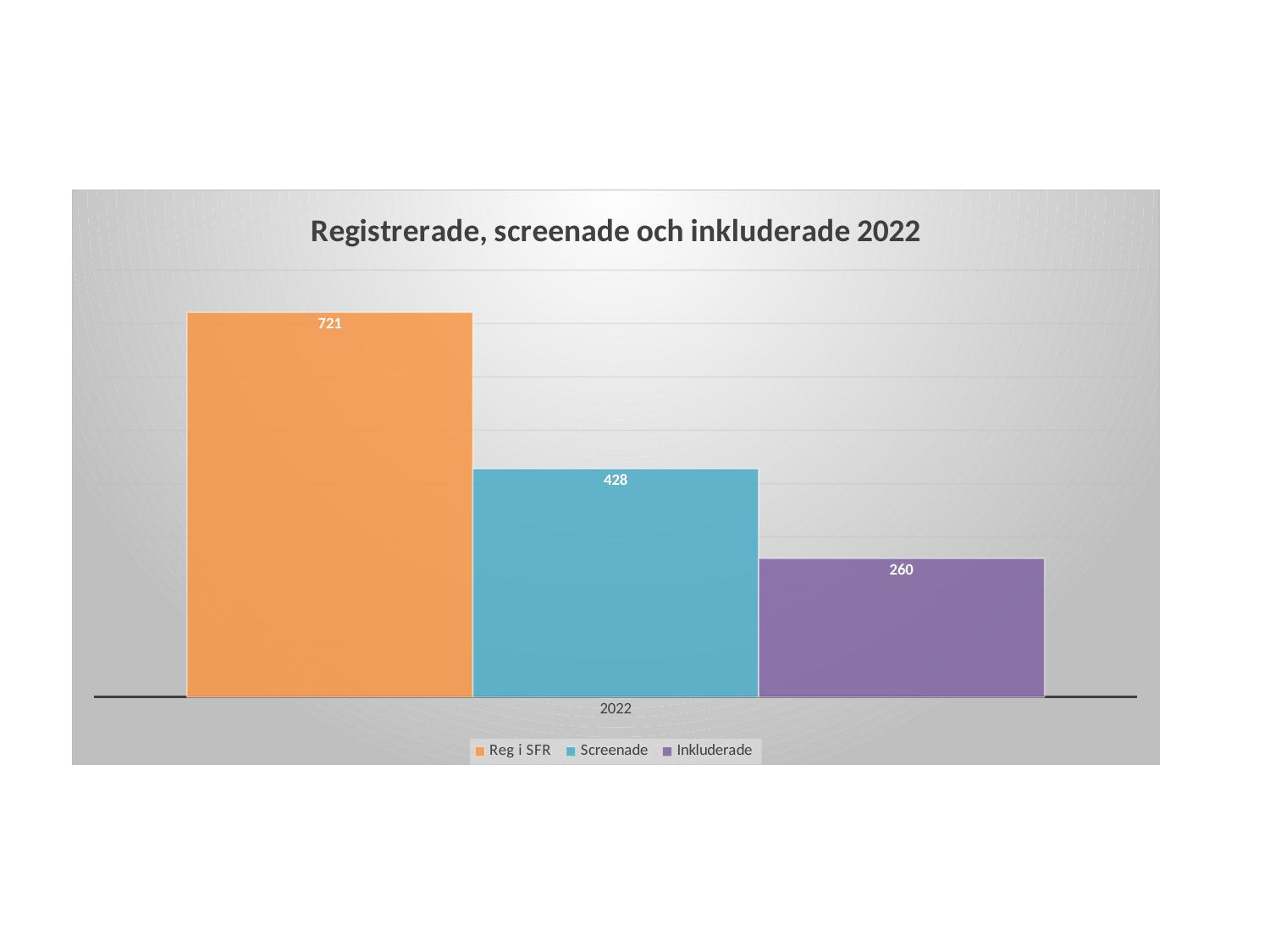
What is the value for Inkluderade in 2022? 260 What is the value for Screenade in 2022? 428 What is the value for Reg i SFR in 2022? 721 What colour is the Screenade bar? Blue Which is larger, Screenade or Inkluderade? Screenade Which series has the lowest value? Inkluderade What kind of chart is shown? Bar chart Which series has the highest value? Reg i SFR What is the difference between Reg i SFR and Screenade? 293 What is the difference between Screenade and Inkluderade? 168 How many series does the legend list? 3 What is the title of the chart? Registrerade, screenade och inkluderade 2022